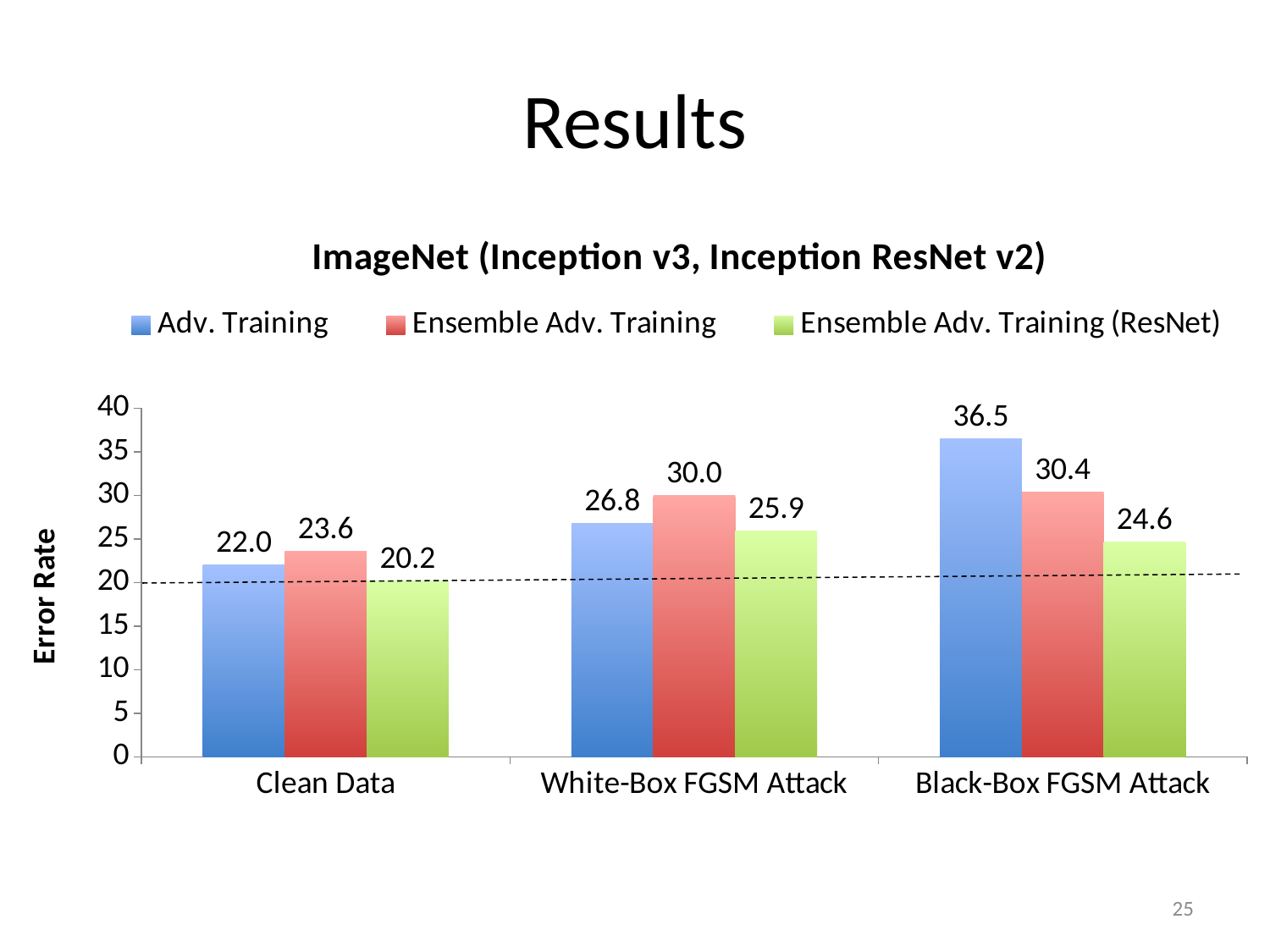
What is the title of the chart? ImageNet (Inception v3, Inception ResNet v2) How many series does the legend list? 3 Which series has the highest error rate under the Black-Box FGSM Attack? Adv. Training Which is larger under the White-Box FGSM Attack: the error rate for Adv. Training or for Ensemble Adv. Training? Ensemble Adv. Training What kind of chart is shown on the slide? Bar chart Is the error rate for Adv. Training under the Black-Box FGSM Attack greater or less than 35? greater What is the error rate for Adv. Training on Clean Data? 22.0 Which series has the lowest error rate on Clean Data? Ensemble Adv. Training (ResNet) What is the difference between the Adv. Training error rate under the Black-Box FGSM Attack and on Clean Data? 14.5 How many categories are shown on the x axis? 3 What is the error rate for Ensemble Adv. Training under the White-Box FGSM Attack? 30.0 What is the error rate for Ensemble Adv. Training (ResNet) under the Black-Box FGSM Attack? 24.6